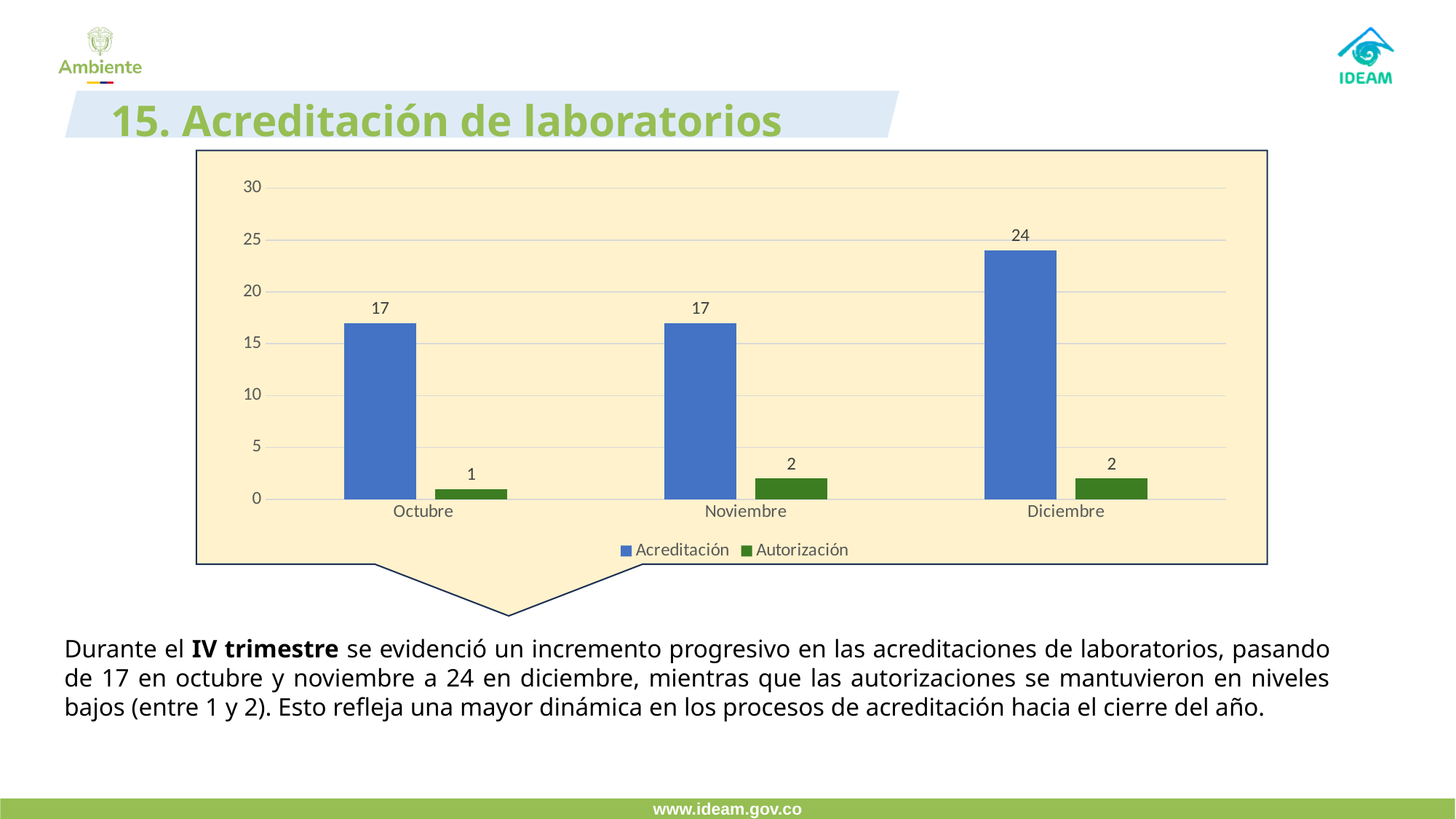
What is the Autorización value for Octubre? 1 How many months are shown on the x axis? 3 Is the Acreditación value for Diciembre greater or less than 20? greater What is the difference between the Acreditación values for Diciembre and Octubre? 7 What is the Acreditación value for Noviembre? 17 What is the Acreditación value for Diciembre? 24 Which month has the highest Acreditación value? Diciembre Which month has the lowest Autorización value? Octubre Which is larger in Noviembre, Acreditación or Autorización? Acreditación How many series does the legend list? 2 What kind of chart is shown on the slide? Bar chart Which colour represents Autorización in the chart? Green